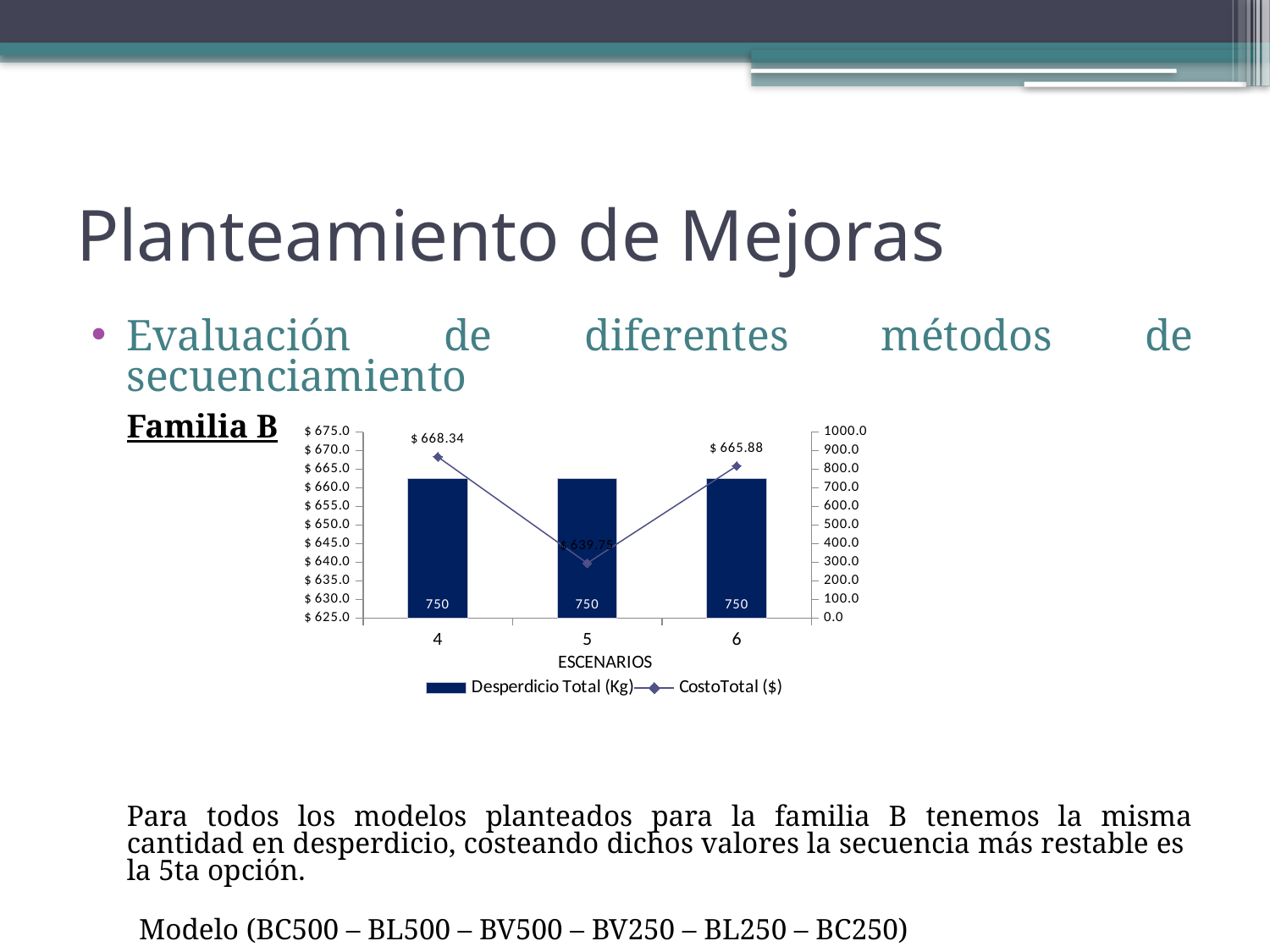
How many series does the chart legend list? 2 Which escenario has the highest CostoTotal ($)? 4 Does the CostoTotal ($) line rise or fall from escenario 5 to escenario 6? Rise How many escenarios are shown on the x axis of the chart? 3 What is the CostoTotal ($) value for escenario 4? $ 668.34 What is the Desperdicio Total (Kg) value for escenario 5? 750 What is the x-axis title of the chart? ESCENARIOS Which escenario has the lowest CostoTotal ($)? 5 What is the CostoTotal ($) value for escenario 6? $ 665.88 What is the CostoTotal ($) value for escenario 5? $ 639.75 Which has a larger CostoTotal ($), escenario 4 or escenario 6? Escenario 4 What is the difference in CostoTotal ($) between escenario 4 and escenario 5? $ 28.59